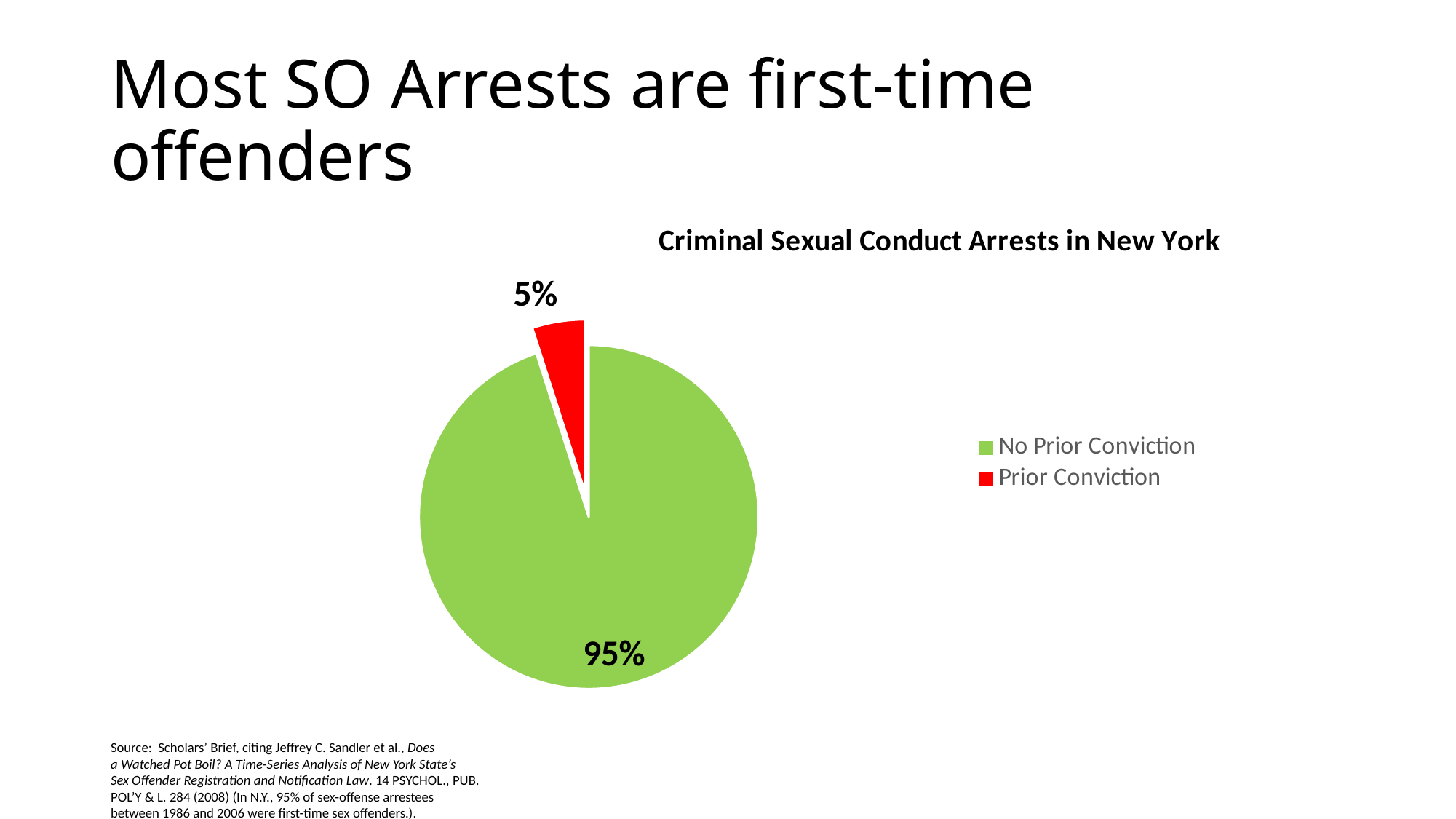
How many entries does the legend list? 2 What percentage of arrests are labelled Prior Conviction? 5% Which category has the largest share of the pie? No Prior Conviction What is the difference in percentage points between No Prior Conviction and Prior Conviction? 90 How many slices does the pie chart have? 2 What is the title of the chart? Criminal Sexual Conduct Arrests in New York Which category has the smallest share of the pie? Prior Conviction What percentage of arrests are labelled No Prior Conviction? 95% What type of chart is shown on the slide? pie chart What colour is the Prior Conviction slice? red What share of the pie does the No Prior Conviction slice represent? 95% Which is larger, the share for No Prior Conviction or the share for Prior Conviction? No Prior Conviction